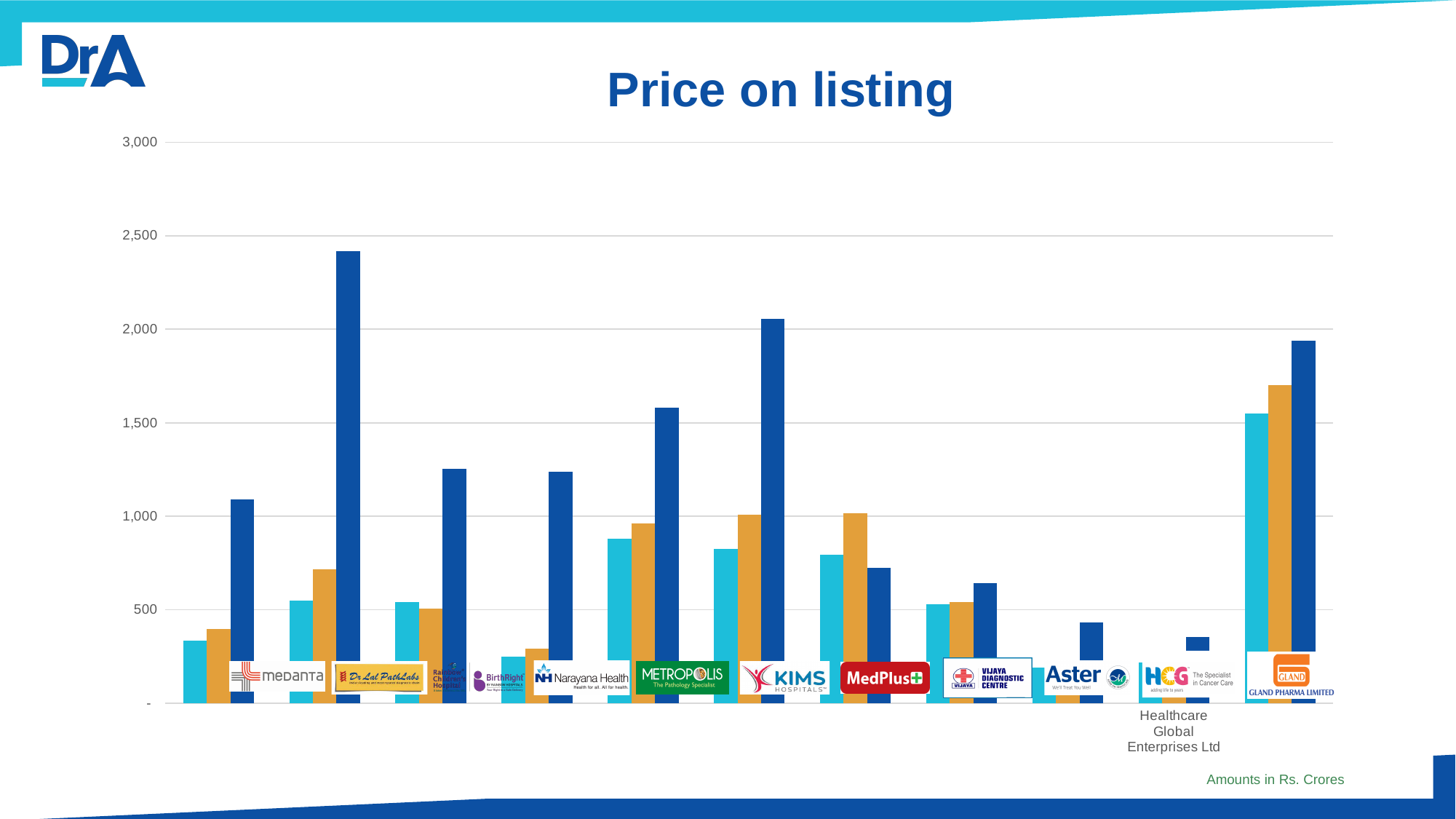
Is the orange bar for Medanta greater or less than 500? less Is the dark blue bar for Dr Lal PathLabs greater or less than 2,000? greater Which company has the tallest dark blue bar in the chart? Dr Lal PathLabs Which company has the shortest dark blue bar in the chart? Healthcare Global Enterprises Ltd What is the title of the chart? Price on listing Which is larger, the dark blue bar for Metropolis or the dark blue bar for Narayana Health? Metropolis How many companies are shown along the x axis of the chart? 11 In what units are the amounts in the chart expressed, according to the note on the slide? Rs. Crores Is the dark blue bar for KIMS Hospitals greater or less than 1,500? greater What kind of chart is shown on the slide? bar chart Which is larger, the dark blue bar for KIMS Hospitals or the dark blue bar for Gland Pharma? KIMS Hospitals